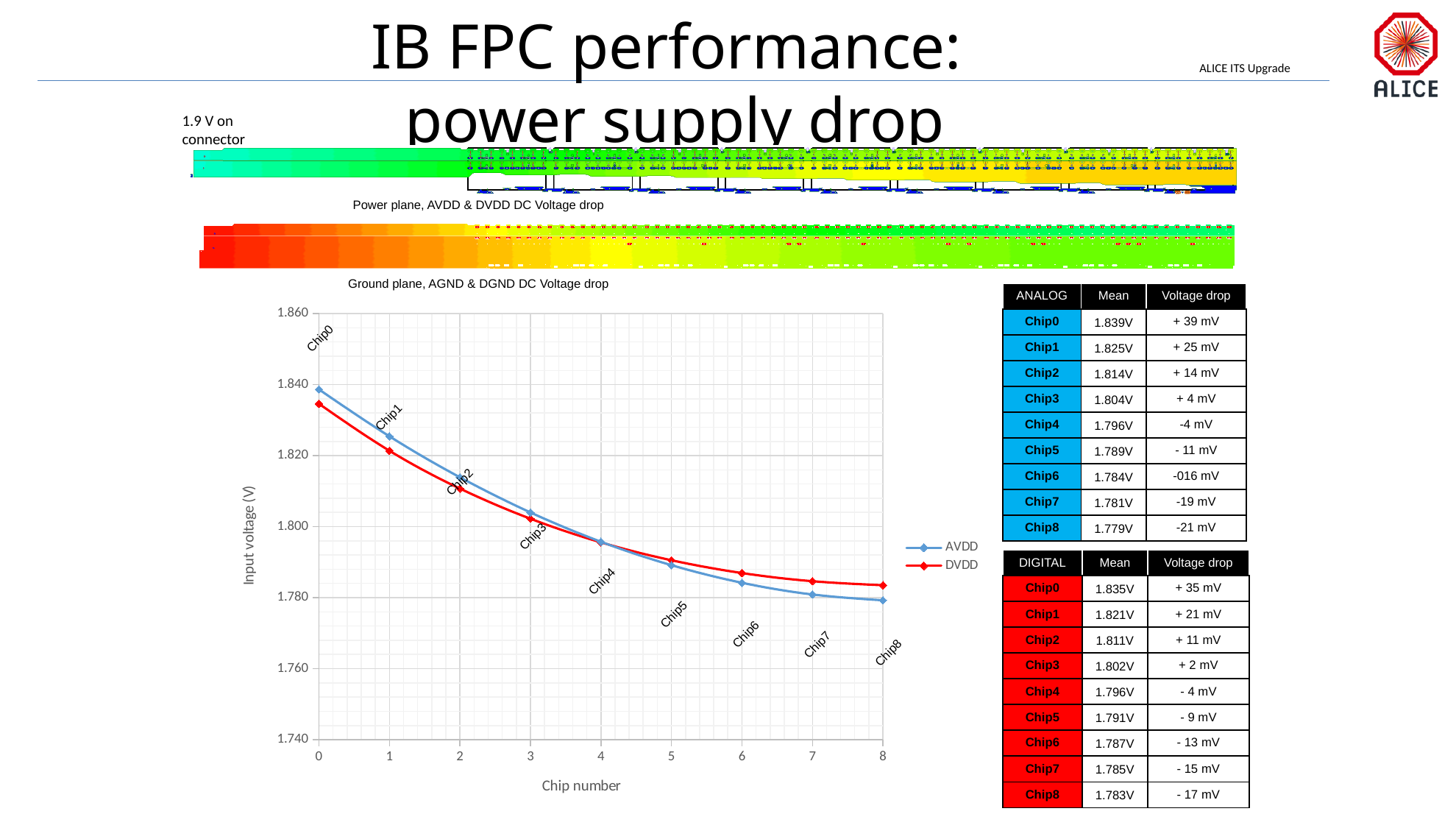
How many chip numbers are plotted along the x axis of the chart? 9 Is the DVDD value at chip number 2 greater or less than 1.800? greater What are the two series named in the chart legend? AVDD and DVDD At which chip number is the DVDD input voltage lowest? 8 At which chip number is the AVDD input voltage highest? 0 How many series does the chart legend list? 2 Is the AVDD value at chip number 0 greater or less than 1.820? greater What kind of chart is shown on the slide? line chart Do the AVDD values rise or fall as the chip number increases? fall At chip number 0, which series has the higher input voltage, AVDD or DVDD? AVDD At chip number 8, which series has the higher input voltage, AVDD or DVDD? DVDD Is the DVDD value at chip number 8 greater or less than 1.800? less